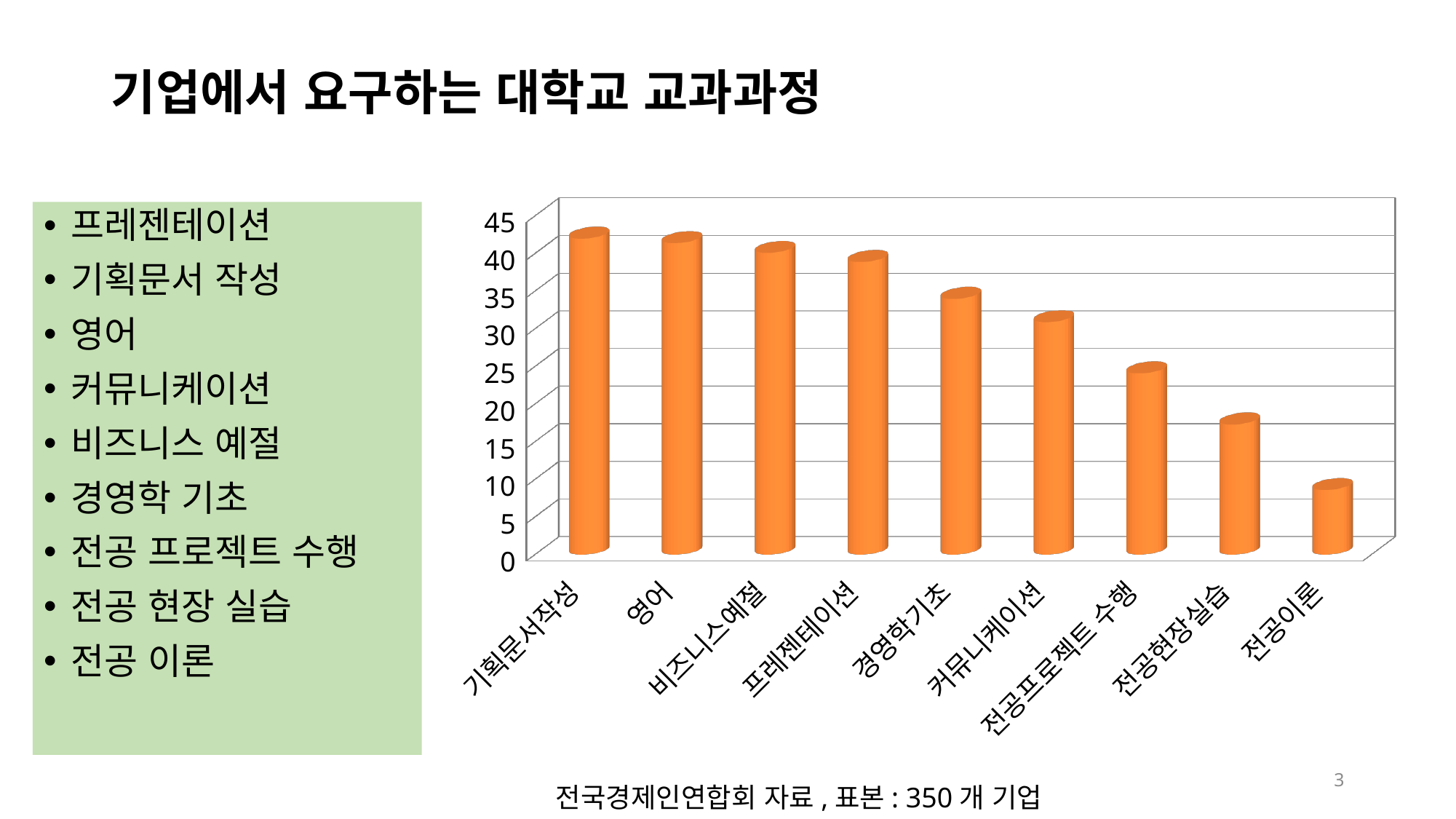
Which category has the lowest value in the chart? 전공이론 Do the values rise or fall from left to right along the x axis? fall Is the value for 전공이론 greater or less than 10? less Which is larger, the value for 영어 or the value for 경영학기초? 영어 Is the value for 기획문서작성 greater or less than 40? greater What is the highest tick value shown on the vertical axis of the chart? 45 What kind of chart is shown on the slide? bar chart Is the value for 커뮤니케이션 greater or less than 35? less How many categories are shown on the x axis of the chart? 9